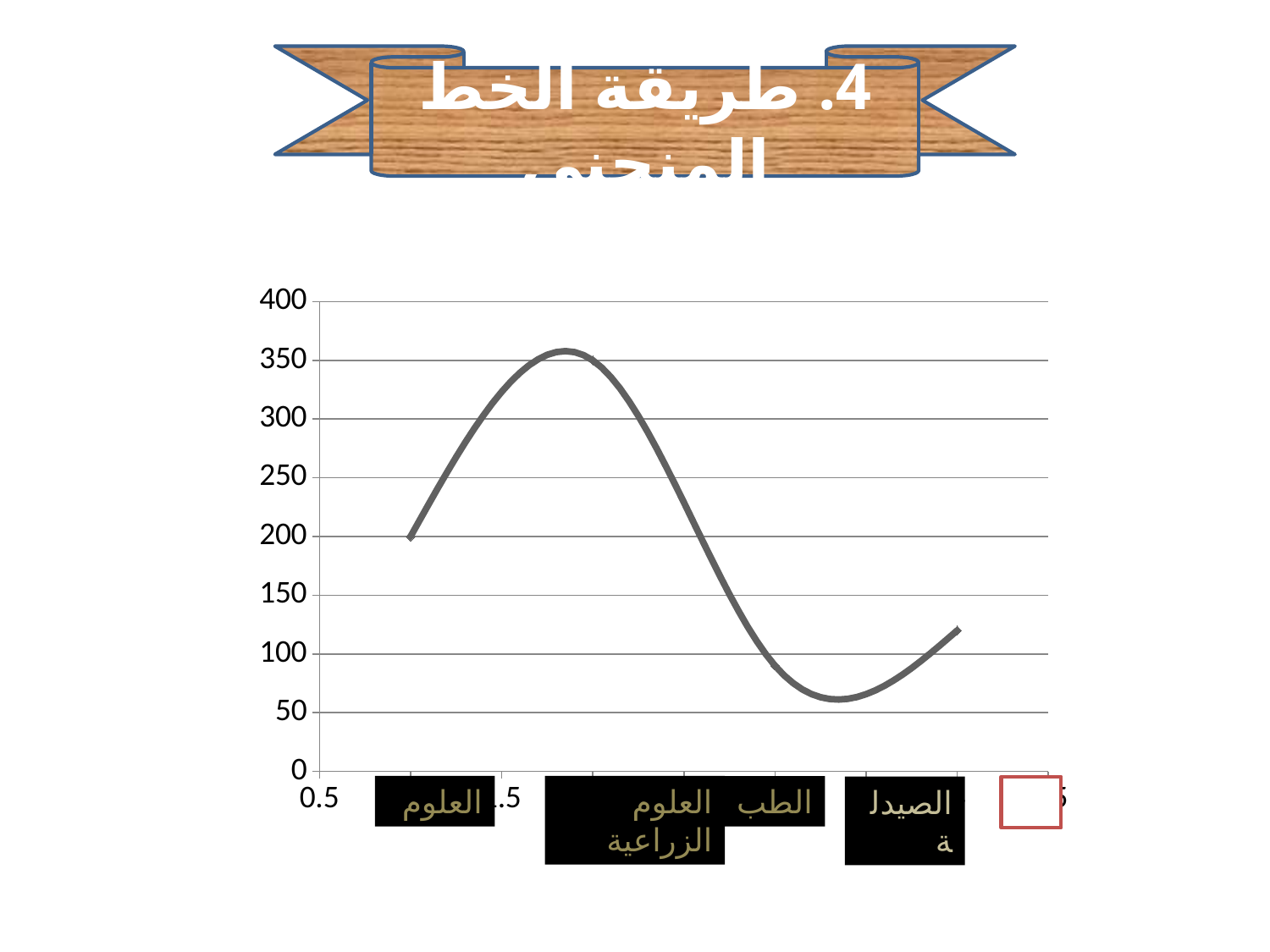
Does the curve rise or fall between العلوم الزراعية and الطب? fall Is the value for الطب greater or less than 150? less How many categories are labelled on the x axis of the chart? 4 Is the value for الصيدلة greater or less than 200? less Which is larger, the value for العلوم الزراعية or the value for الطب? العلوم الزراعية Which category has the highest value on the curve? العلوم الزراعية Is the value for العلوم greater or less than 150? greater What is the title shown in the banner above the chart? 4. طريقة الخط المنحني What kind of chart is shown on the slide? line chart What is the highest value shown on the y axis of the chart? 400 Which is larger, the value for العلوم or the value for الصيدلة? العلوم